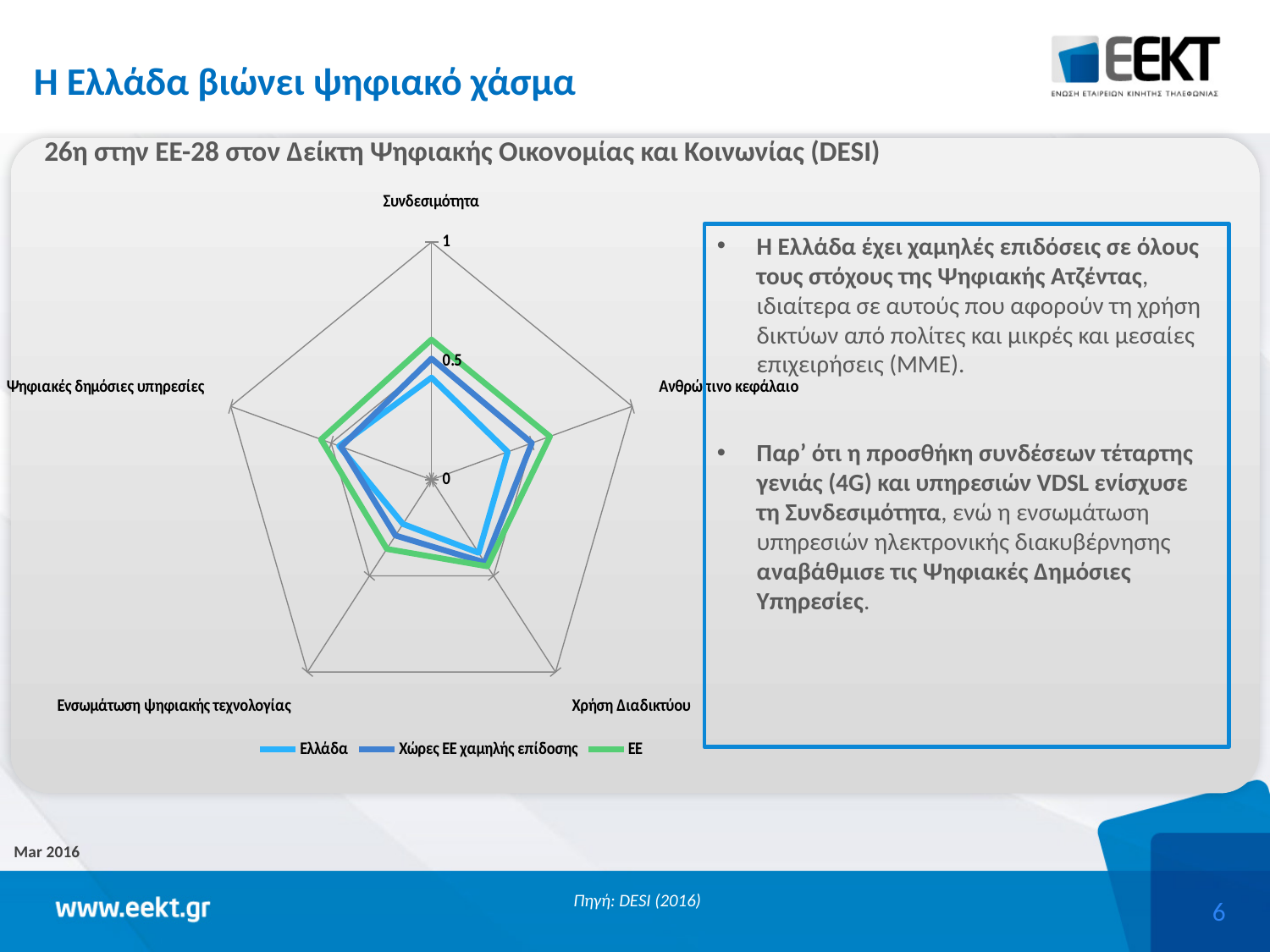
Which series are listed in the legend of the radar chart? Ελλάδα, Χώρες ΕΕ χαμηλής επίδοσης, ΕΕ On Ανθρώπινο κεφάλαιο, which is larger: the value for Ελλάδα or the value for ΕΕ? ΕΕ What kind of chart is shown on the slide? Radar chart How many series does the legend of the radar chart list? 3 On Χρήση Διαδικτύου, which is larger: the value for ΕΕ or the value for Ελλάδα? ΕΕ On Συνδεσιμότητα, which is larger: the value for ΕΕ or the value for Ελλάδα? ΕΕ Is the value for Ελλάδα on Συνδεσιμότητα greater or less than 0.5? less Is the value for Ελλάδα on Ανθρώπινο κεφάλαιο greater or less than 0.5? less What is the maximum value shown on the radar chart's scale? 1 Is the value for ΕΕ on Ανθρώπινο κεφάλαιο greater or less than 0.5? greater How many axes (categories) does the radar chart have? 5